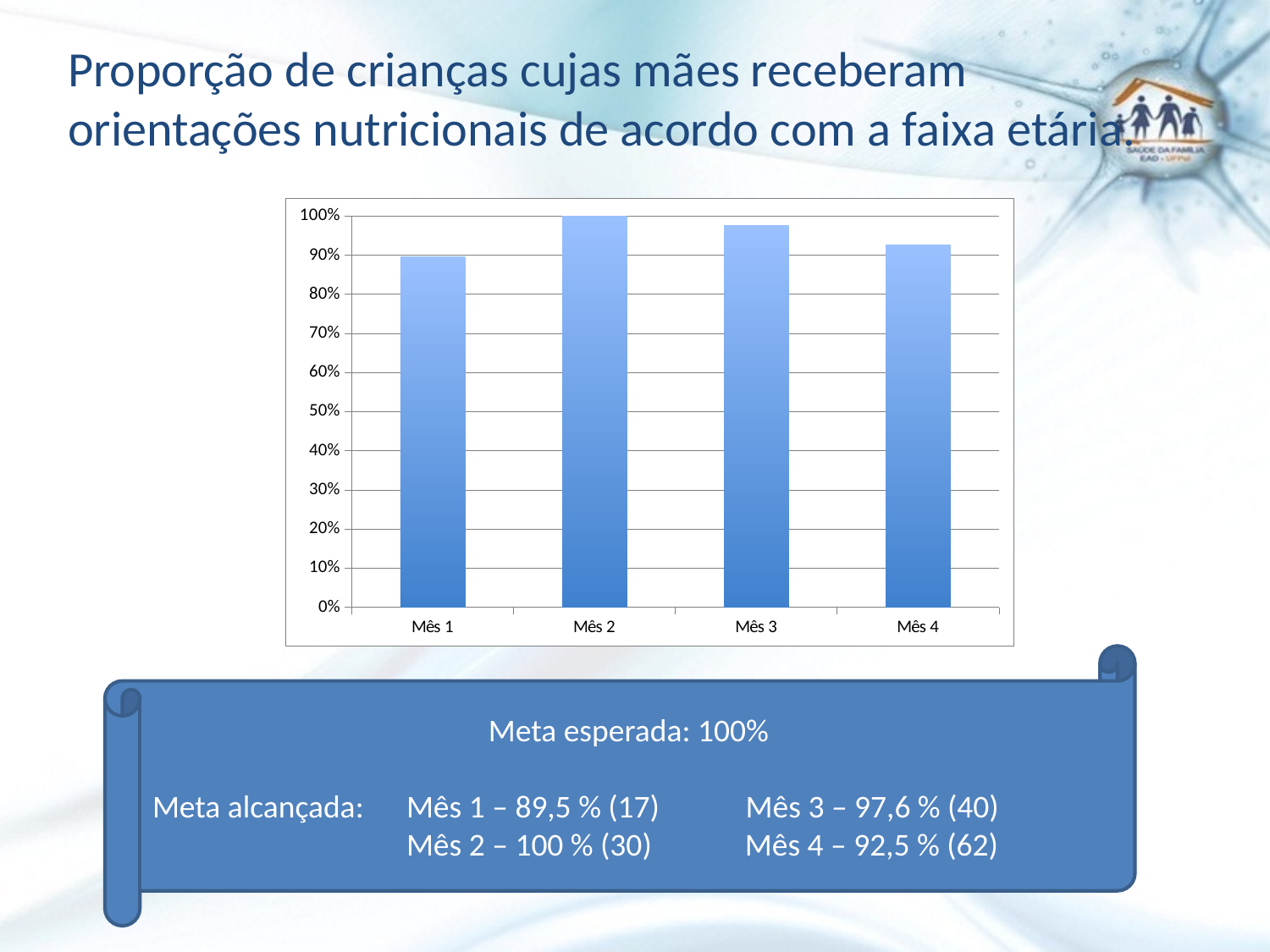
What is the expected target (meta esperada) stated on the slide? 100% Is the value for Mês 1 greater or less than 90%? less What is the value for Mês 3 according to the slide? 97,6 % Which is larger, the value for Mês 3 or the value for Mês 4? Mês 3 How many categories (months) are shown on the x axis of the chart? 4 What is the difference between the value for Mês 2 and the value for Mês 1? 10,5 % What kind of chart is shown on the slide? bar chart Which month has the highest bar in the chart? Mês 2 What is the value for Mês 2 in the chart? 100 % What is the value for Mês 1 according to the slide? 89,5 % Which month has the lowest bar in the chart? Mês 1 What is the value for Mês 4 according to the slide? 92,5 %